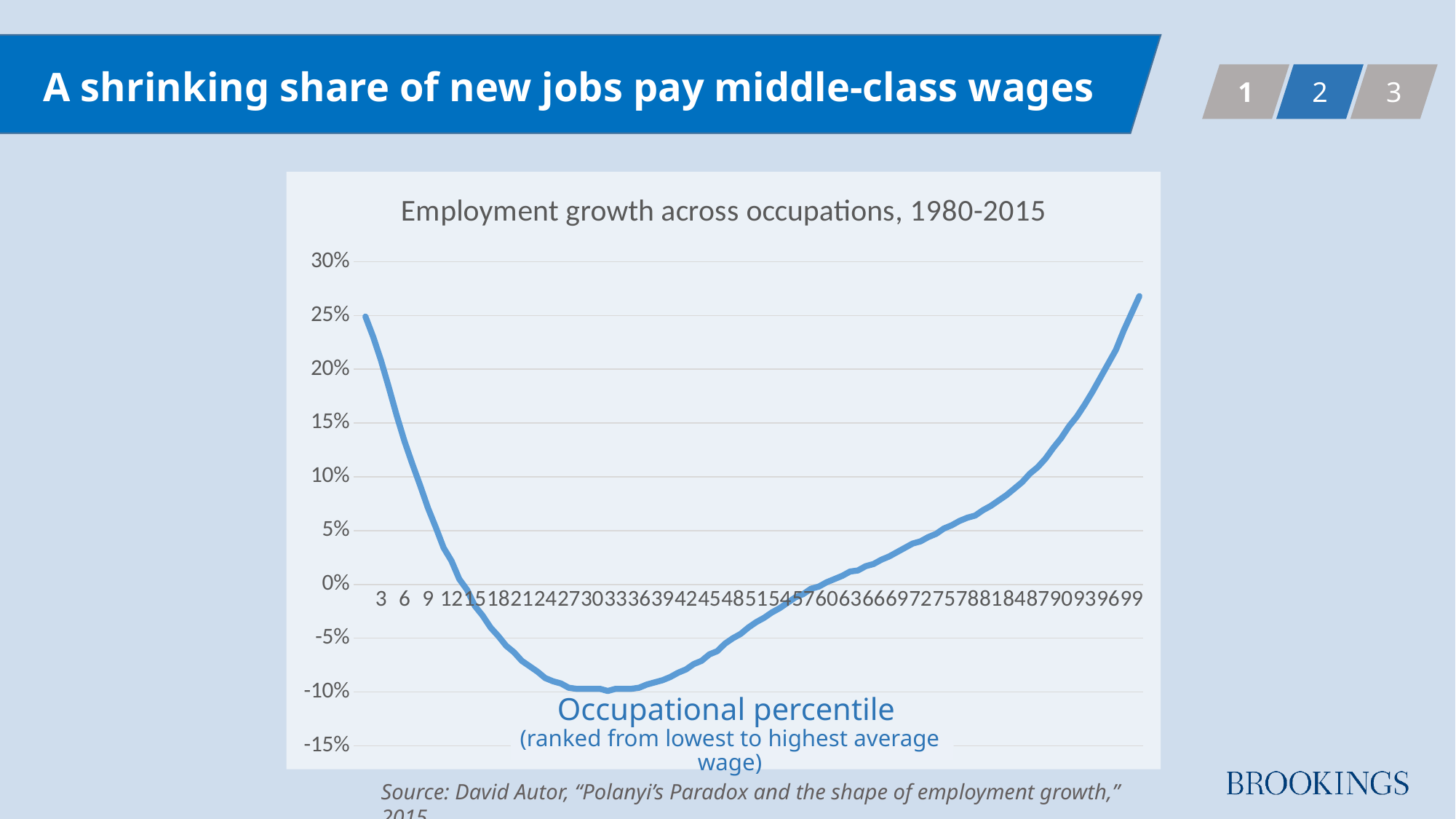
Is the employment growth value at occupational percentile 60 greater or less than 5%? less What kind of chart is shown on the slide? line chart Moving from the lowest to the highest occupational percentile, does the employment growth line first fall and then rise, or first rise and then fall? first fall and then rise Is the employment growth value at occupational percentile 90 greater or less than 10%? greater How many lines are plotted on the chart? 1 Is the employment growth value at occupational percentile 45 greater or less than 0%? less Which has the higher employment growth value: occupational percentile 3 or occupational percentile 90? 3 What is the title of the chart? Employment growth across occupations, 1980-2015 What is the label of the x axis of the chart? Occupational percentile (ranked from lowest to highest average wage)